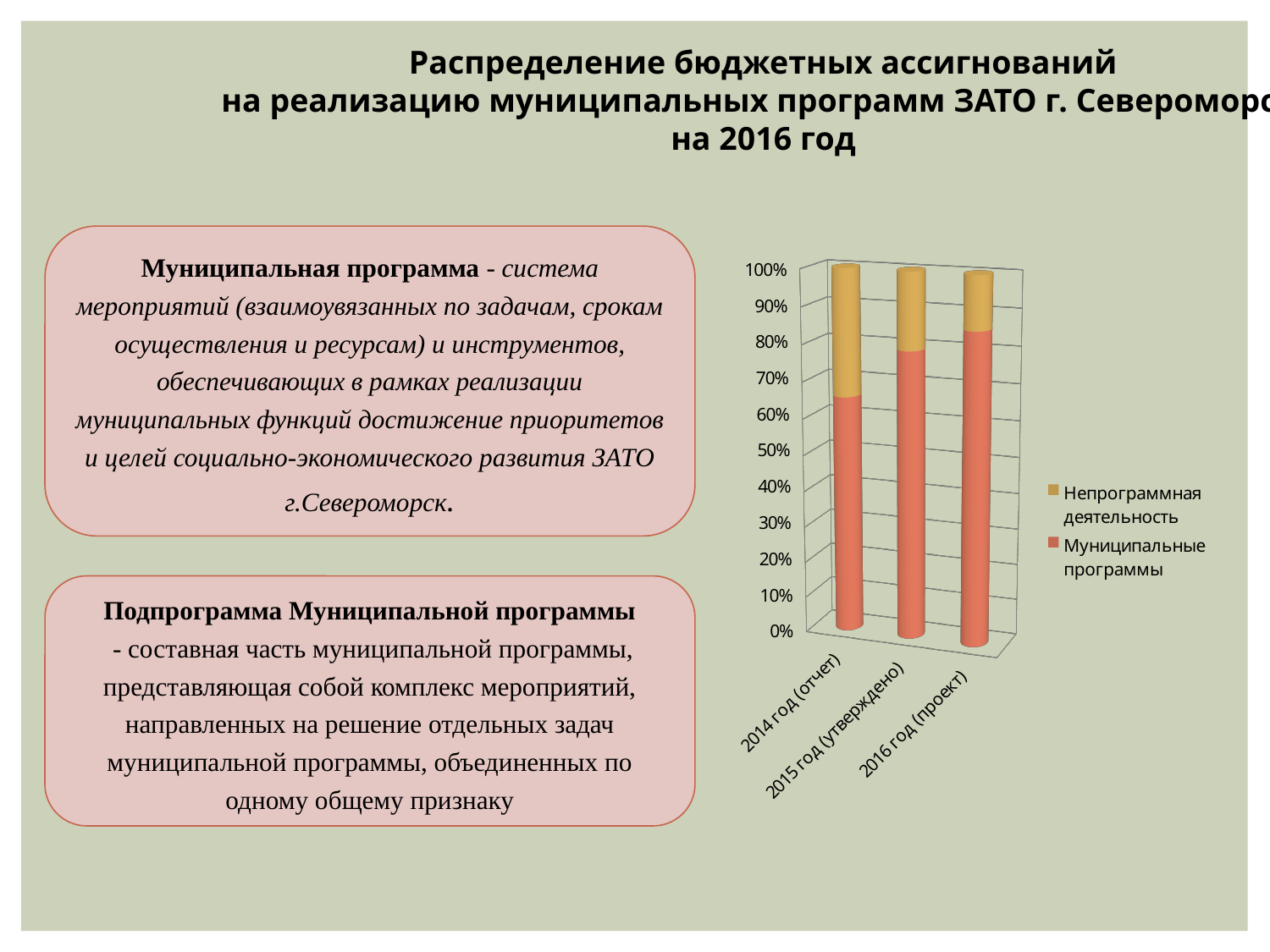
Is the share of Муниципальные программы for 2015 год (утверждено) greater or less than 70%? greater Is the share of Муниципальные программы for 2014 год (отчет) greater or less than 60%? greater Which series is shown in red/orange in the chart? Муниципальные программы How many series does the chart legend list? 2 Which series is shown in yellow in the chart? Непрограммная деятельность Which year has the lowest share of Муниципальные программы? 2014 год (отчет) How many categories (years) are shown on the x axis of the chart? 3 What kind of chart is shown on the slide? Stacked bar chart Which year has the highest share of Муниципальные программы? 2016 год (проект) Is the share of Муниципальные программы for 2014 год (отчет) greater or less than 70%? less Which year has the larger share of Непрограммная деятельность: 2014 год (отчет) or 2016 год (проект)? 2014 год (отчет) Does the share of Муниципальные программы rise or fall from 2014 год (отчет) to 2016 год (проект)? rise